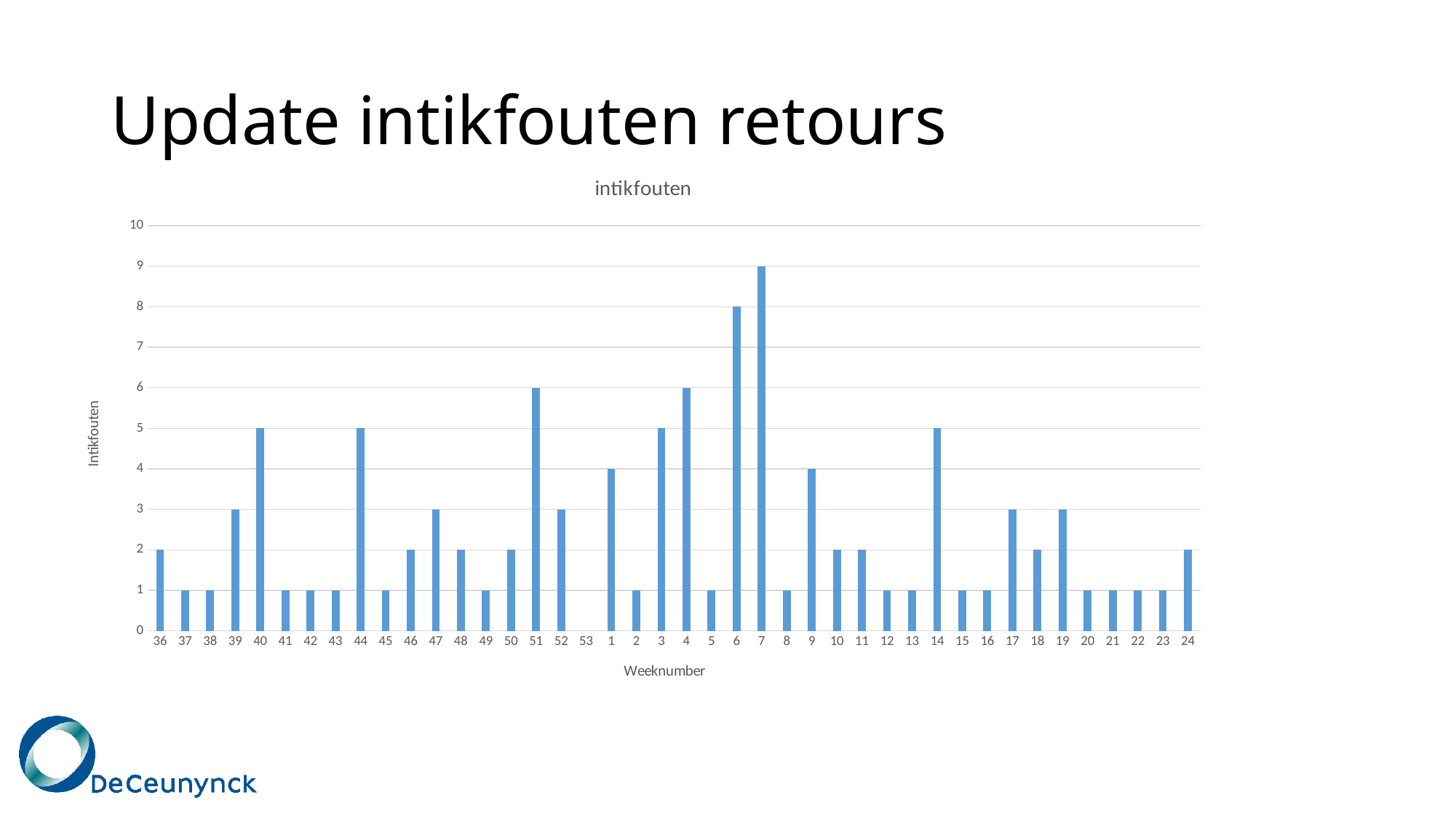
What is the value for week 6? 8 What is the title of the chart? intikfouten Which week number has the highest number of intikfouten? 7 What is the label of the x axis? Weeknumber What type of chart is shown on the slide? Bar chart What is the difference between the values for week 7 and week 6? 1 Which is larger, the value for week 4 or the value for week 3? Week 4 Which week number has the lowest number of intikfouten? 53 How many week numbers are shown on the x axis? 42 What is the value for week 40? 5 What is the value for week 7? 9 What is the value for week 51? 6